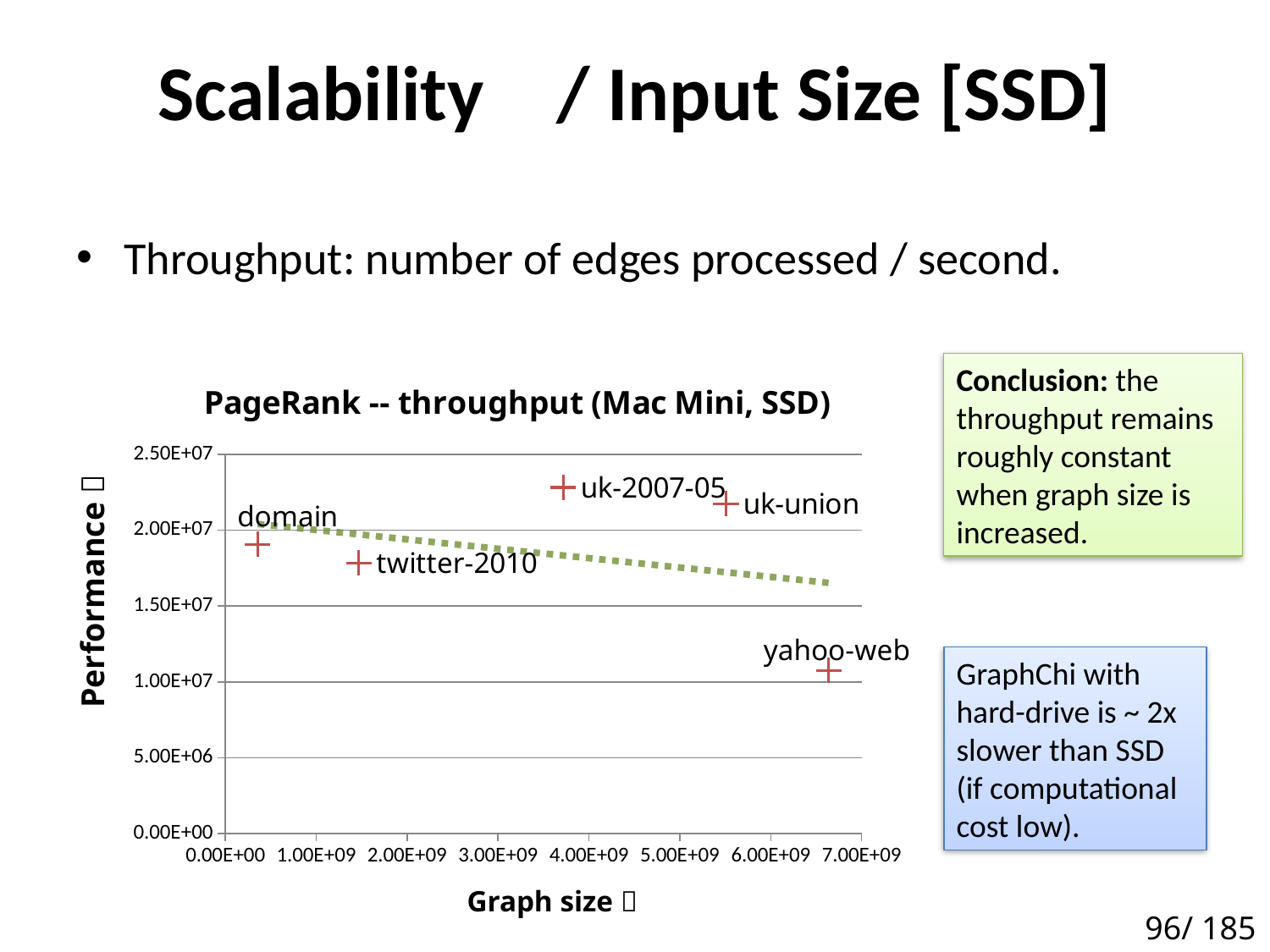
What is the title of the chart? PageRank -- throughput (Mac Mini, SSD) Which data point has the highest performance value? uk-2007-05 What kind of chart is shown on the slide? scatter plot Which has a higher performance value, domain or yahoo-web? domain Which data point has the largest graph size on the x axis? yahoo-web Is the performance value for uk-2007-05 greater or less than 2.00E+07? greater Does the dotted trend line rise or fall as graph size increases? fall Is the performance value for twitter-2010 greater or less than 2.00E+07? less Is the performance value for yahoo-web greater or less than 1.50E+07? less How many labeled data points are plotted in the chart? 5 Which has a higher performance value, uk-2007-05 or twitter-2010? uk-2007-05 Which data point has the lowest performance value? yahoo-web